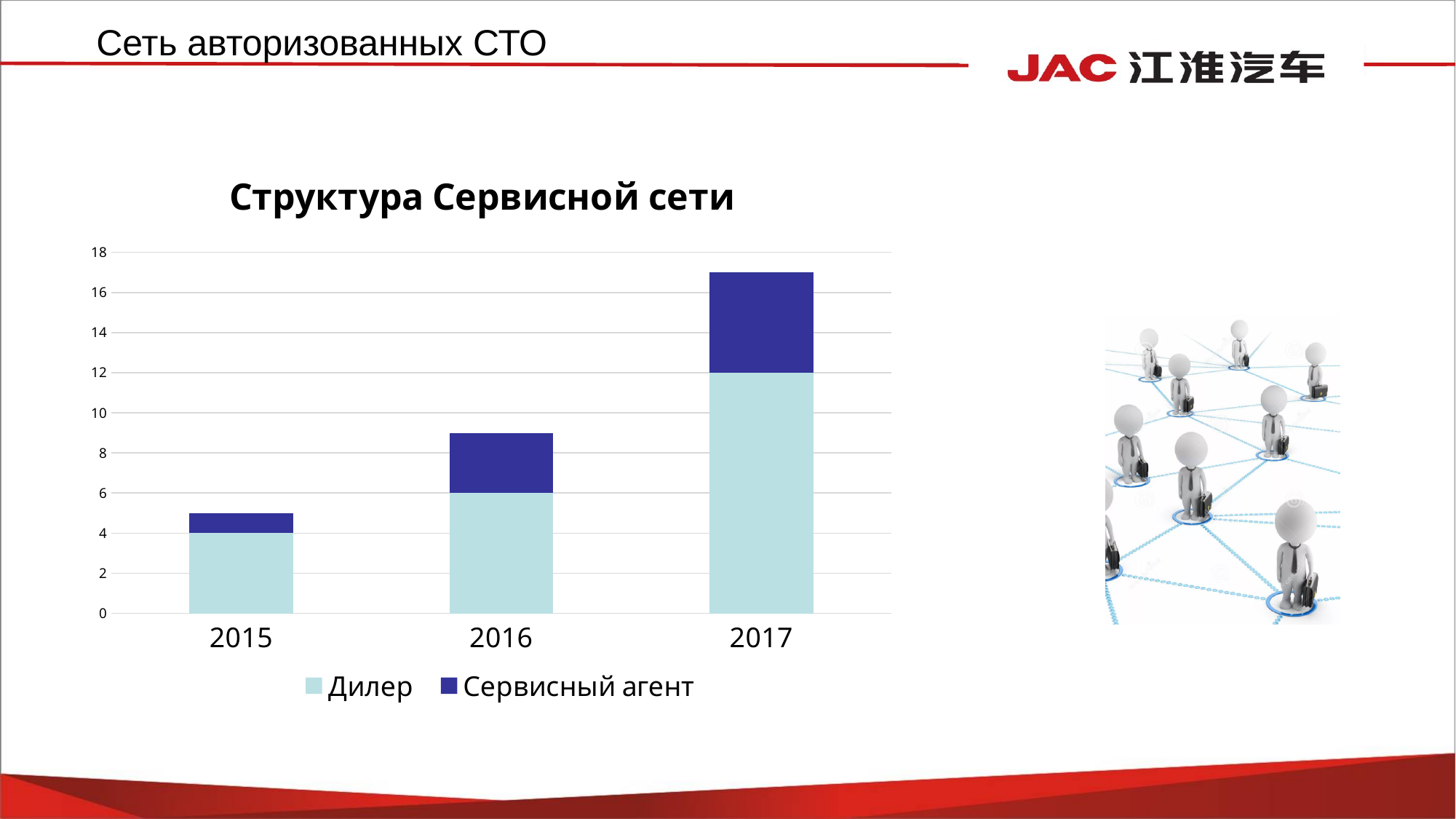
What is the title of the chart? Структура Сервисной сети Do the total bar values rise or fall from 2015 to 2017? rise How many series does the chart legend list? 2 Which year has the lowest total bar? 2015 What is the value for Дилер in 2017? 12 What is the value for Дилер in 2016? 6 Is the total value of the 2017 bar greater or less than 16? greater Which year has the highest total bar? 2017 What is the value for Дилер in 2015? 4 How many years are shown on the x axis of the chart? 3 Is the total value of the 2016 bar greater or less than 8? greater What kind of chart is shown on the slide? Stacked bar chart